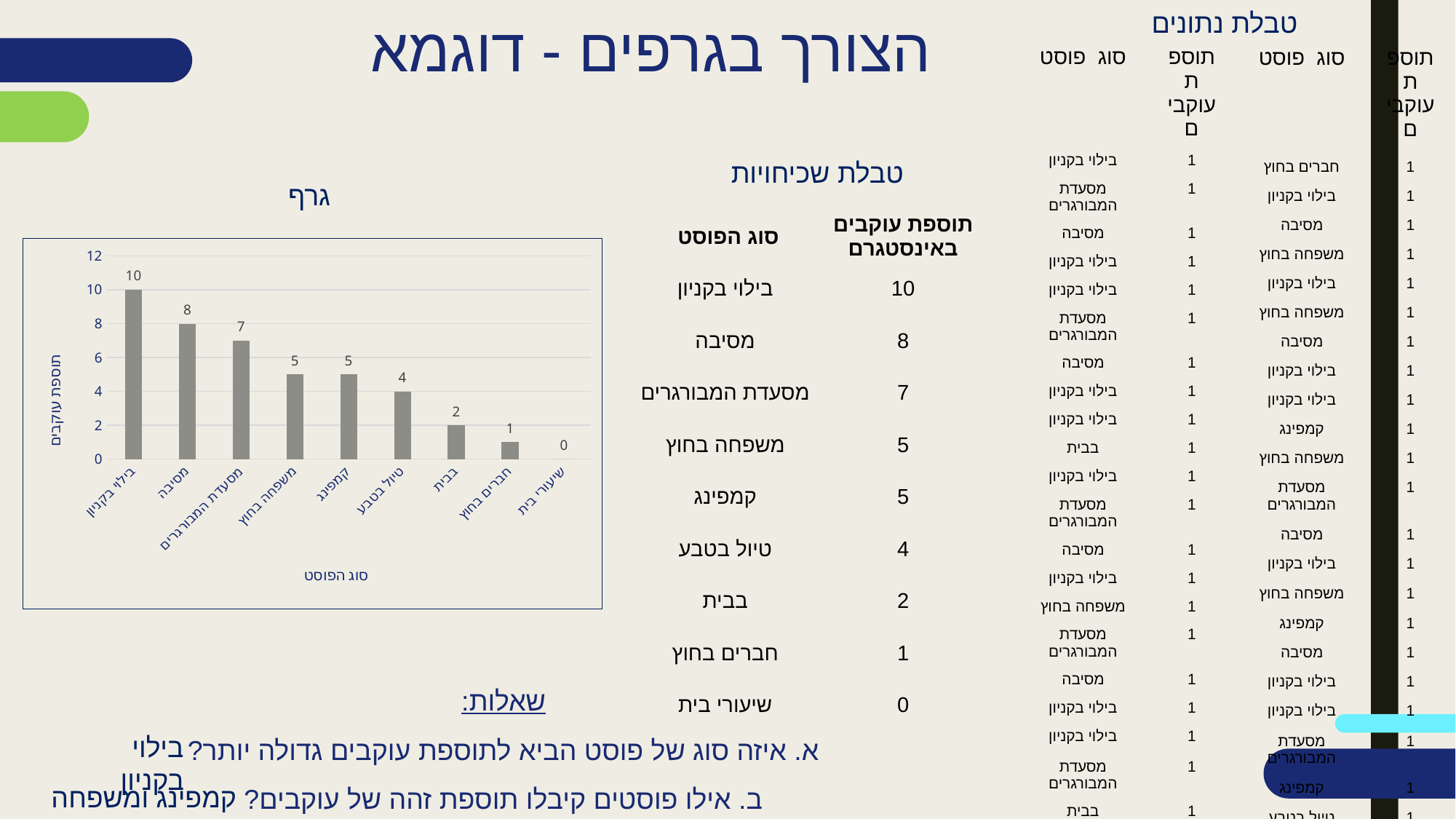
What is the value for טיול בטבע in the chart? 4 What is the title of the chart? גרף Which category has the lowest value in the chart? שיעורי בית Which category has the highest value in the chart? בילוי בקניון What is the label of the vertical axis of the chart? תוספת עוקבים What is the difference between the values for מסיבה and בבית? 6 Do the values rise or fall moving from left to right along the x axis? fall What is the value for בילוי בקניון in the chart? 10 How many categories are plotted on the x axis of the chart? 9 Which is larger, the value for משפחה בחוץ or the value for חברים בחוץ? משפחה בחוץ What type of chart is shown on the slide? bar chart